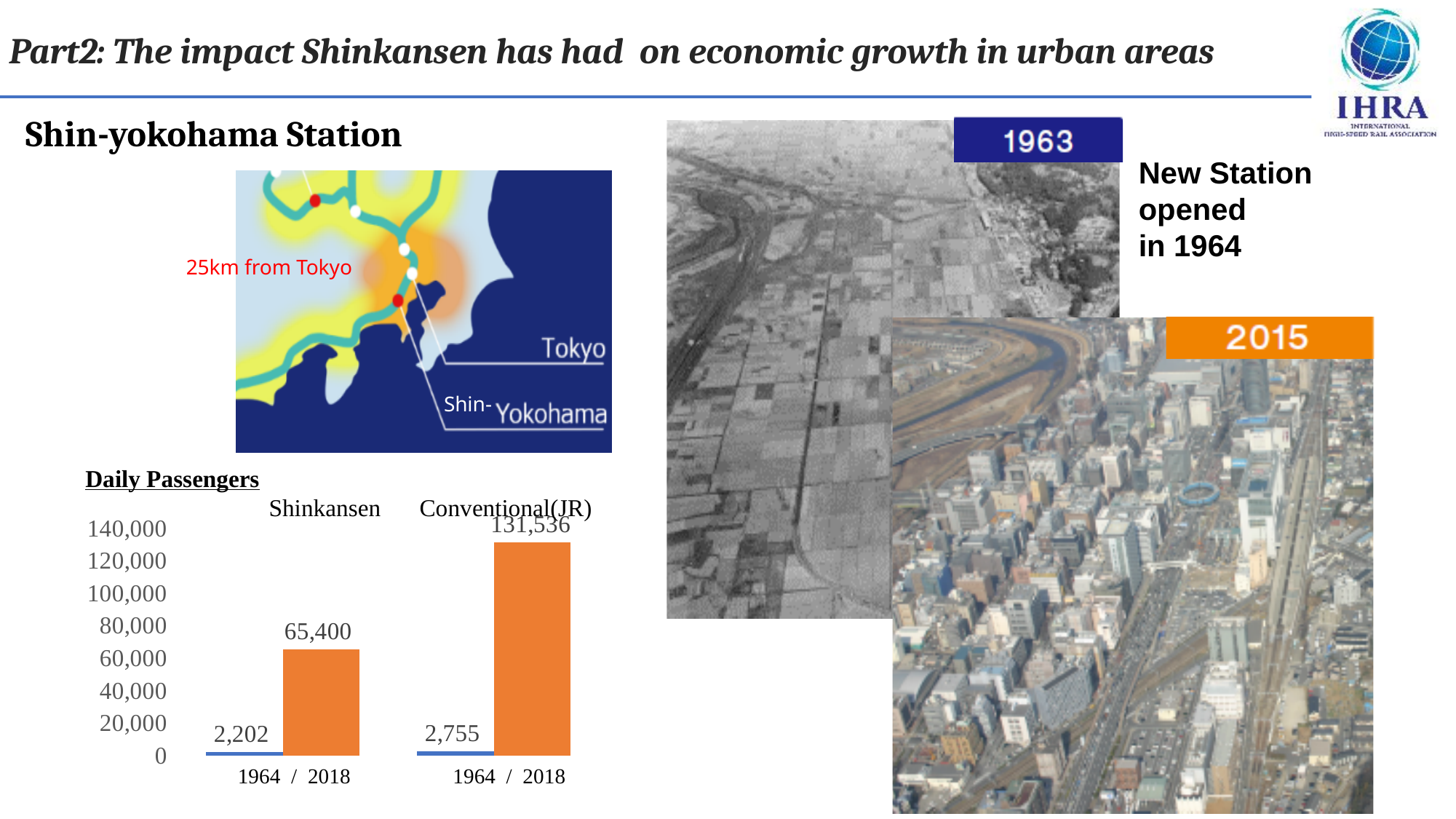
In the Daily Passengers chart, how many daily Shinkansen passengers were there in 2018? 65,400 In the Daily Passengers chart, which is larger: Shinkansen 2018 or Conventional(JR) 2018? Conventional(JR) 2018 In the Daily Passengers chart, which bar shows the highest value? Conventional(JR) 2018 In the Daily Passengers chart, what is the difference between Conventional(JR) daily passengers in 2018 and Shinkansen daily passengers in 2018? 66,136 In the Daily Passengers chart, how many daily Shinkansen passengers were there in 1964? 2,202 What is the title of the chart on the slide? Daily Passengers In the Daily Passengers chart, how many daily Conventional(JR) passengers were there in 1964? 2,755 In the Daily Passengers chart, how many daily Conventional(JR) passengers were there in 2018? 131,536 In the Daily Passengers chart, which bar shows the lowest value? Shinkansen 1964 In the Daily Passengers chart, what is the difference between Shinkansen daily passengers in 2018 and in 1964? 63,198 What kind of chart is the Daily Passengers chart? bar chart In the Daily Passengers chart, is the value for Conventional(JR) in 2018 greater or less than 120,000? greater